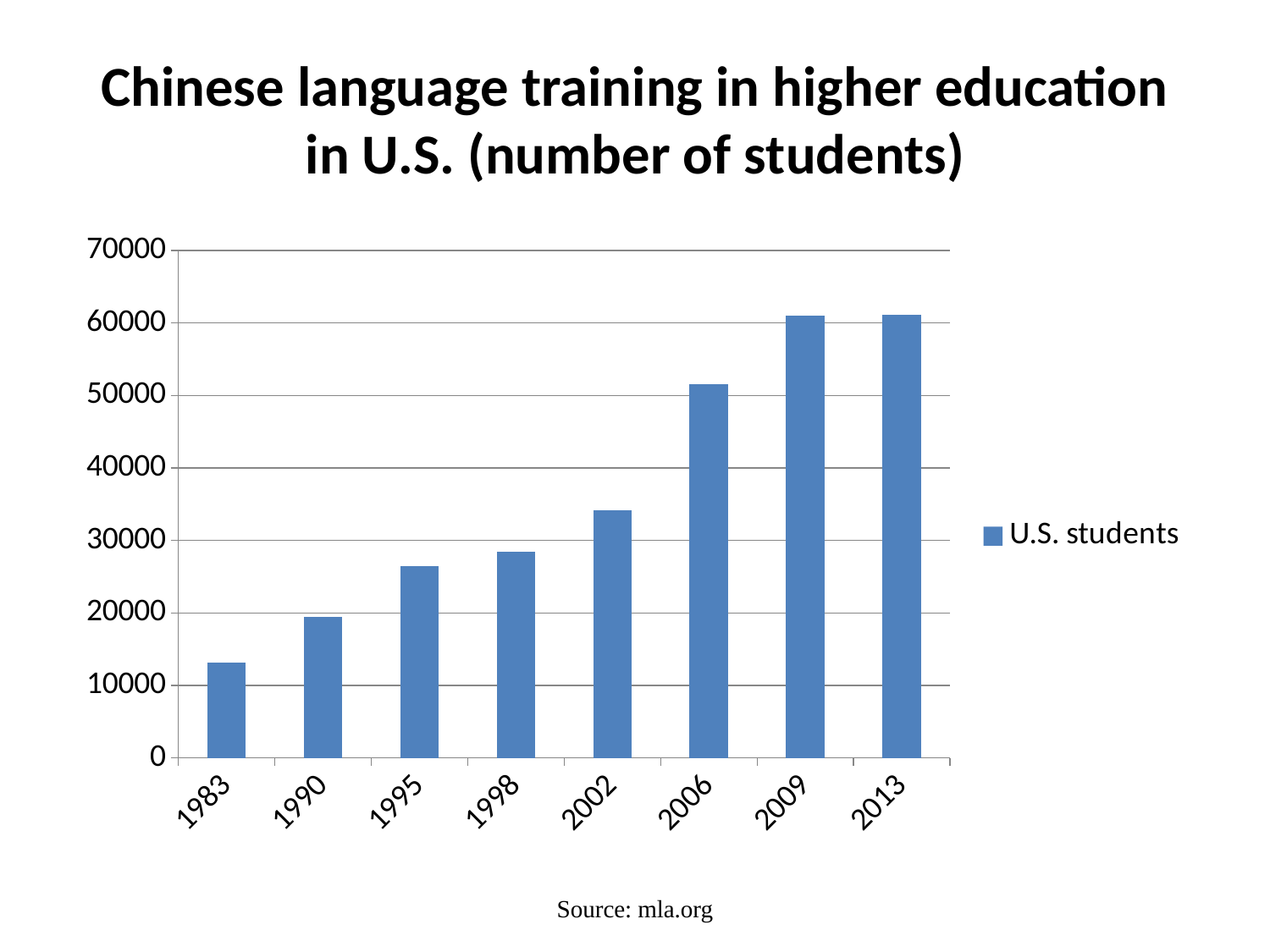
Is the value for 1990 greater or less than 20000? less Which year has the lowest number of U.S. students? 1983 Is the value for 2002 greater or less than 30000? greater How many series does the legend list? 1 Is the value for 1998 greater or less than 30000? less What is the name of the series shown in the legend? U.S. students How many years are shown on the x axis of the chart? 8 Do the values generally rise or fall from 1983 to 2013? rise What kind of chart is shown on the slide? bar chart Which year has the larger number of U.S. students, 2002 or 2006? 2006